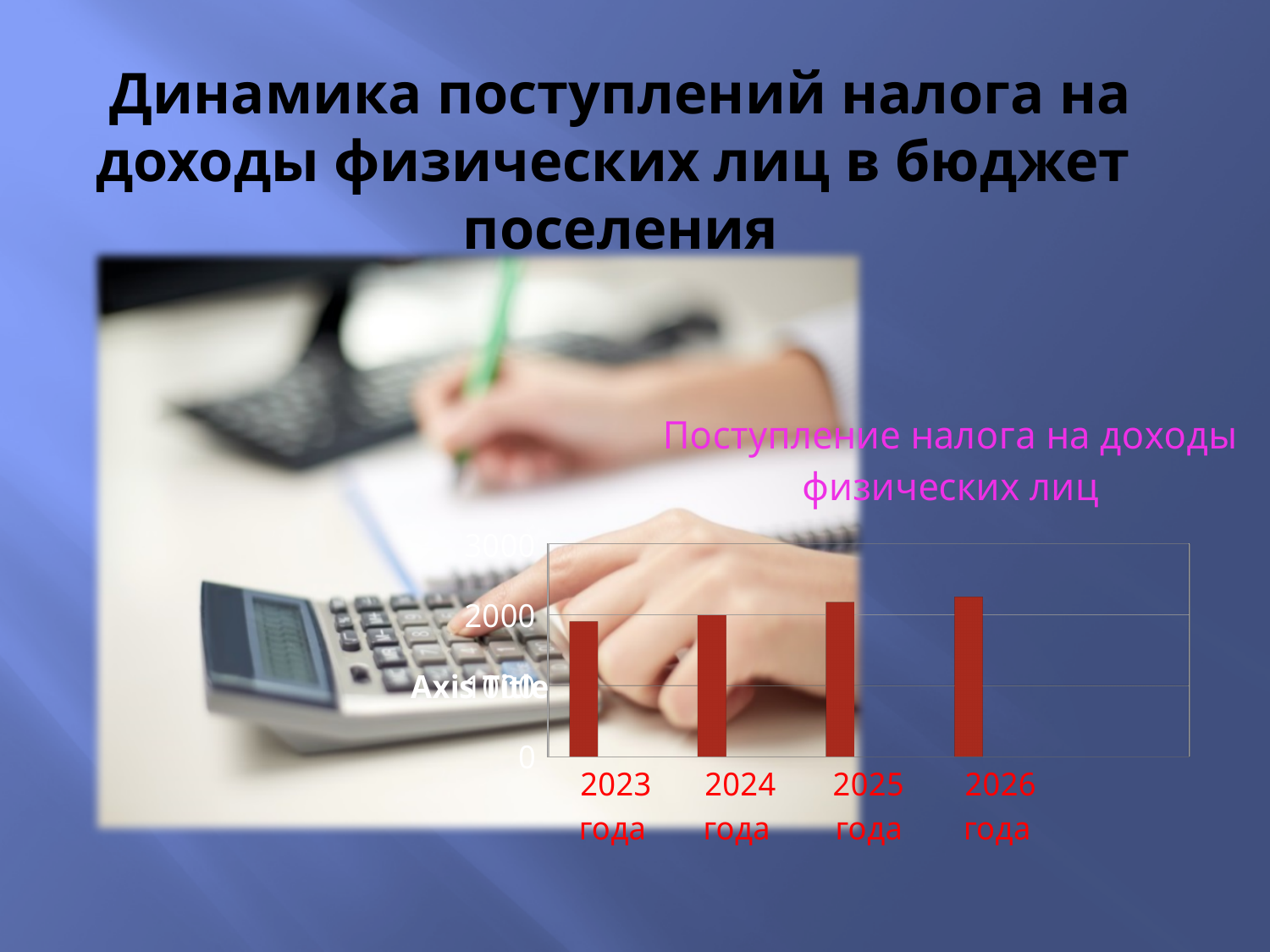
Is the value for 2024 года greater or less than 1000? greater Is the value for 2025 года greater or less than 2000? greater What is the title of the chart? Поступление налога на доходы физических лиц Which is larger, the value for 2023 года or the value for 2025 года? 2025 года What kind of chart is shown on the slide? bar chart Do the values rise or fall from 2023 года to 2026 года? rise Which is larger, the value for 2023 года or the value for 2026 года? 2026 года Is the value for 2026 года greater or less than 2000? greater What is the highest value shown on the vertical axis? 3000 How many years (categories) are plotted on the chart? 4